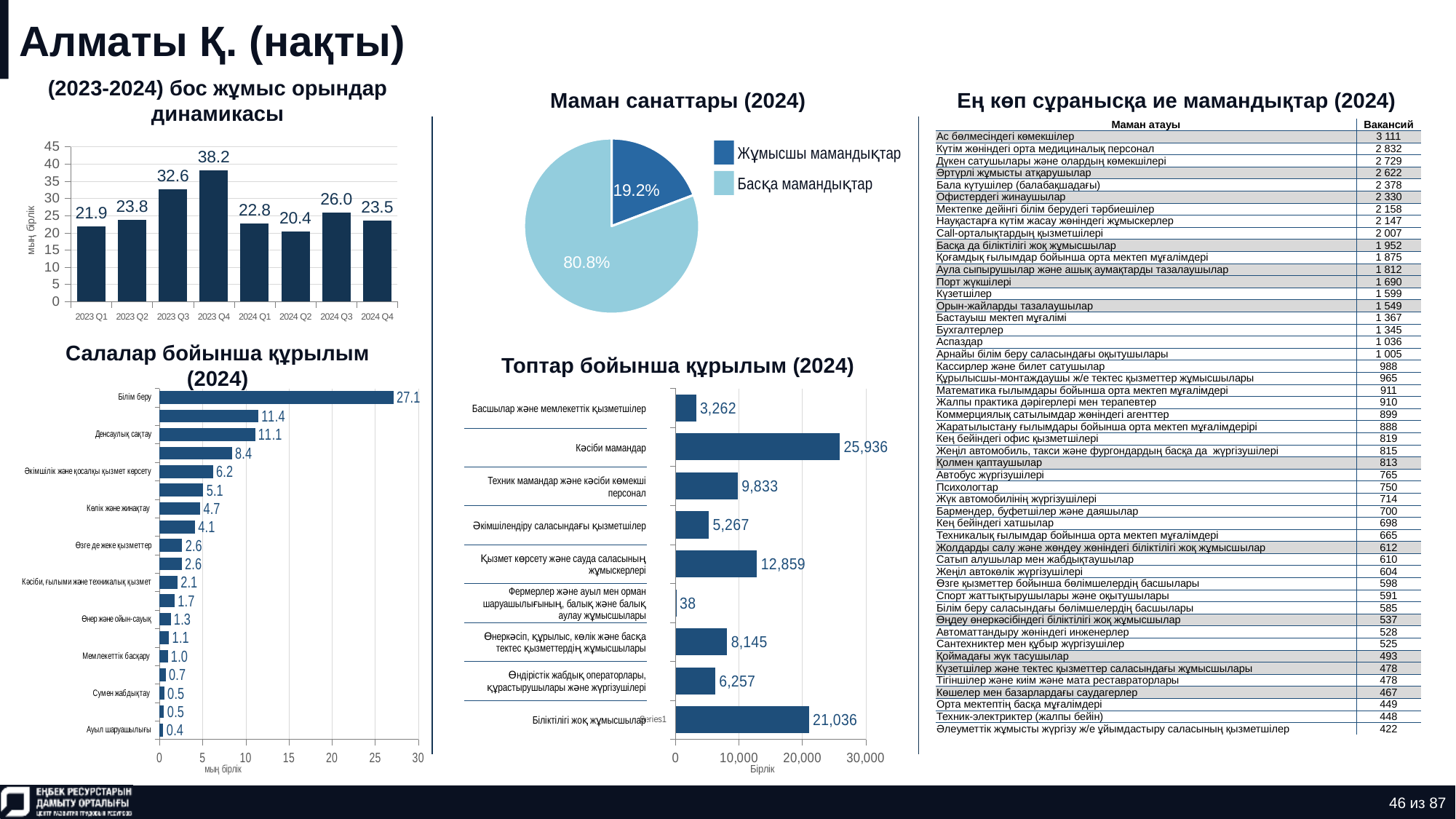
In the chart 'Топтар бойынша құрылым (2024)', what is the value for 'Кәсіби мамандар'? 25,936 In the chart '(2023-2024) бос жұмыс орындар динамикасы', how many quarters are plotted? 8 In the chart 'Салалар бойынша құрылым (2024)', what is the value for 'Ауыл шаруашылығы'? 0.4 In the chart '(2023-2024) бос жұмыс орындар динамикасы', what is the value for 2023 Q4? 38.2 In the chart '(2023-2024) бос жұмыс орындар динамикасы', do the values rise or fall from 2023 Q1 to 2023 Q4? rise In the pie chart 'Маман санаттары (2024)', how many entries does the legend list? 2 In the chart 'Топтар бойынша құрылым (2024)', which is larger: 'Біліктілігі жоқ жұмысшылар' or 'Қызмет көрсету және сауда саласының жұмыскерлері'? Біліктілігі жоқ жұмысшылар In the pie chart 'Маман санаттары (2024)', what share does 'Жұмысшы мамандықтар' have? 19.2% In the chart '(2023-2024) бос жұмыс орындар динамикасы', which quarter has the lowest value? 2024 Q2 In the chart '(2023-2024) бос жұмыс орындар динамикасы', what is the difference between 2023 Q4 and 2024 Q1? 15.4 What kind of chart is 'Топтар бойынша құрылым (2024)'? bar chart In the chart 'Салалар бойынша құрылым (2024)', which category has the highest value? Білім беру